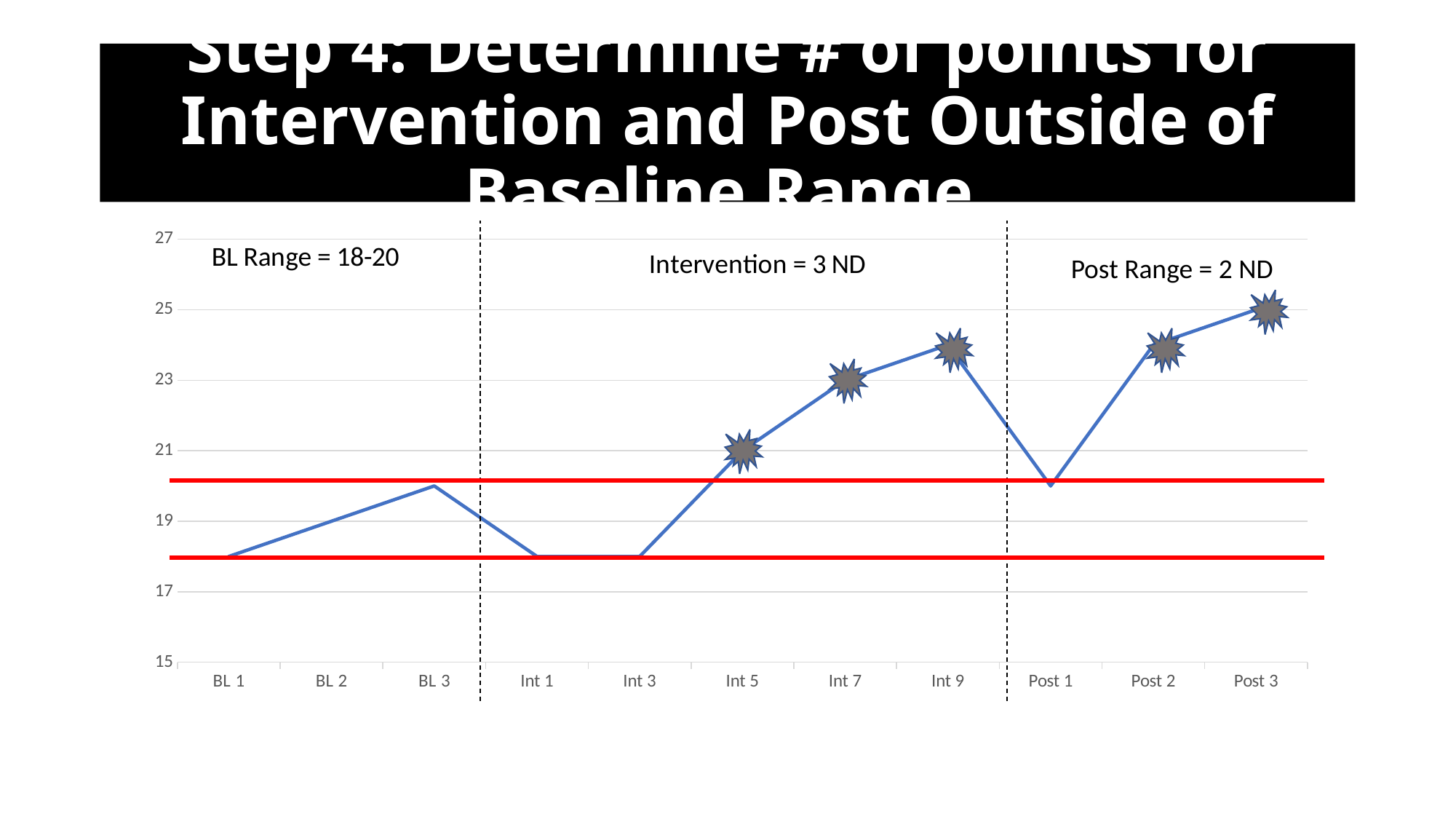
What is the value for Int 5? 21 Is the value for Int 9 greater or less than 23? greater According to the annotation on the chart, what is the BL Range? 18-20 What is the difference between the values for Int 7 and Int 5? 2 Which category has the highest value? Post 3 What kind of chart is shown on the slide? line chart What is the value for Int 7? 23 What is the value for Post 3? 25 How many categories are plotted along the x axis? 11 Which is larger, the value for Post 2 or the value for Post 1? Post 2 Do the values rise or fall from Int 3 to Int 9? rise Is the value for Post 1 greater or less than 21? less